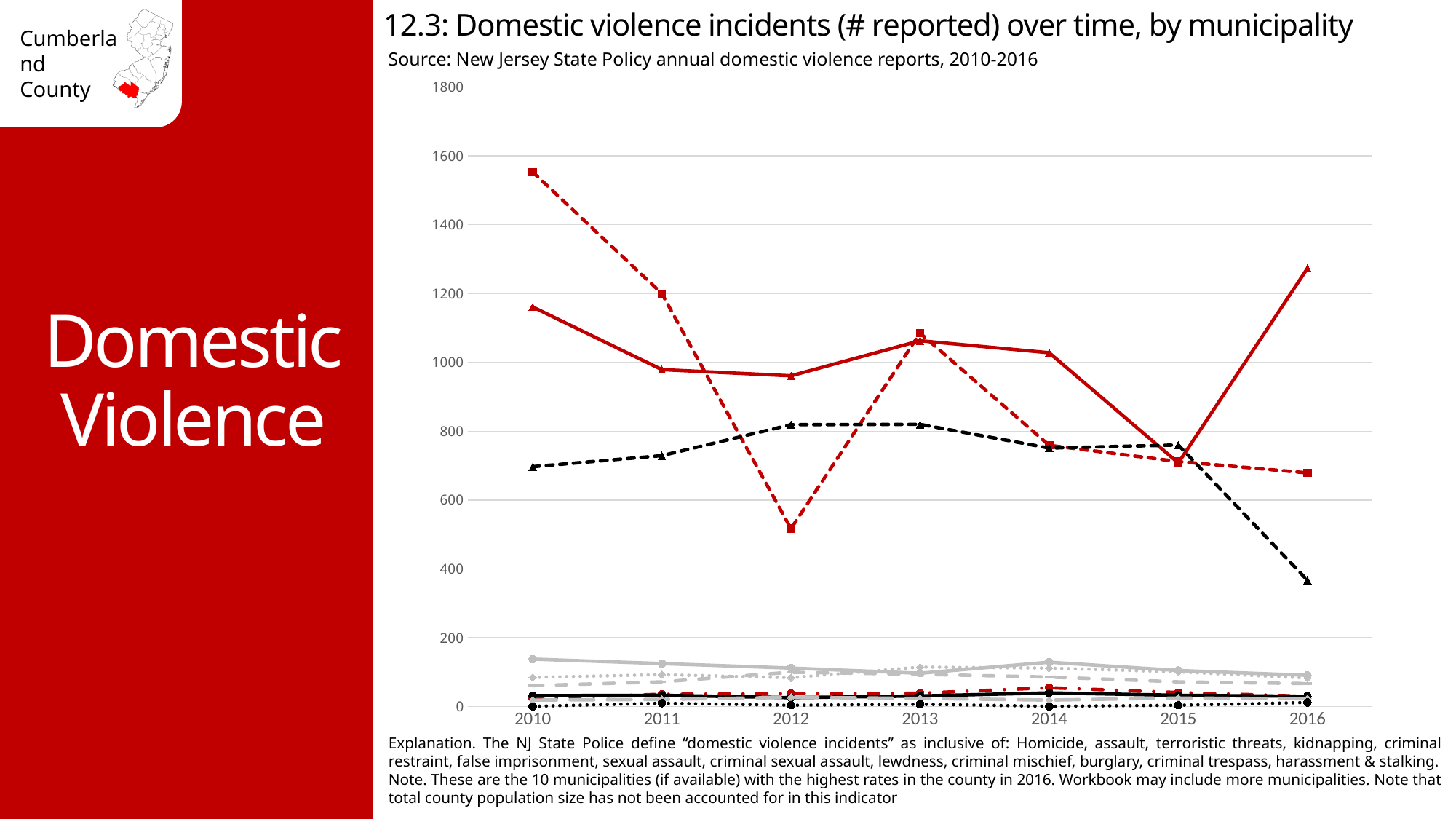
Is the 2016 value of the dashed black line with triangle markers greater or less than 400? less What is the last year shown on the x axis of the chart? 2016 How many years are shown along the x axis of the chart? 7 Does the dashed red line with square markers rise or fall between 2010 and 2012? fall What kind of chart is shown on the slide? line chart Is the 2012 value of the dashed red line with square markers greater or less than 600? less Is the 2016 value of the solid red line with triangle markers greater or less than 1200? greater Does the dashed black line with triangle markers rise or fall between 2015 and 2016? fall Does the solid red line with triangle markers rise or fall between 2015 and 2016? rise What is the first year shown on the x axis of the chart? 2010